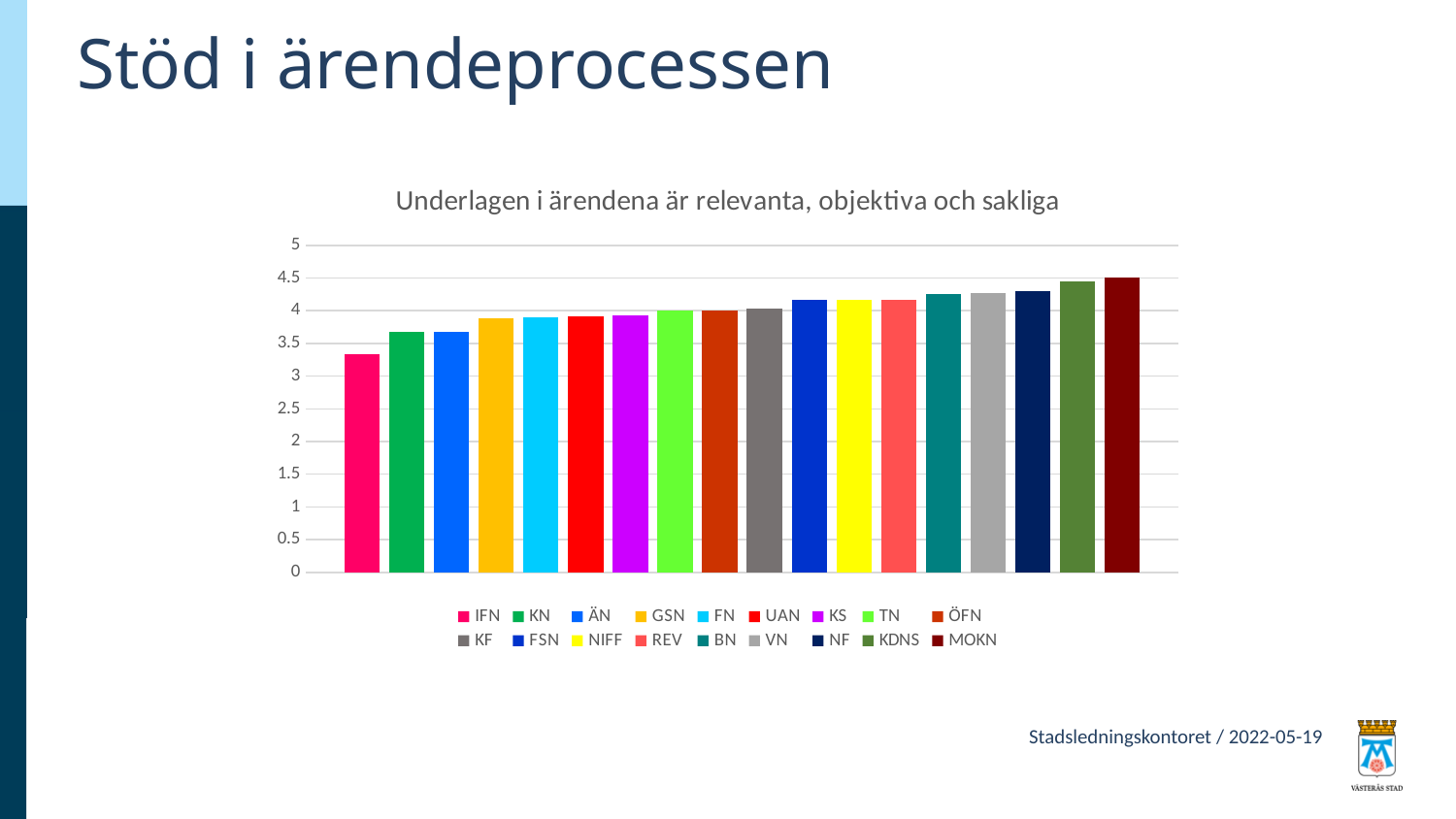
Is the value for IFN greater or less than 3.5? less Do the bar values rise or fall from left to right across the chart? Rise What is the title of the chart? Underlagen i ärendena är relevanta, objektiva och sakliga Which has a larger value, KN or KDNS? KDNS Is the value for KN greater or less than 3.5? greater Is the value for GSN greater or less than 4? less How many bars are plotted in the chart? 18 How many entries does the legend list? 18 What type of chart is shown on the slide? Bar chart Which has a larger value, IFN or MOKN? MOKN Which category has the lowest value? IFN